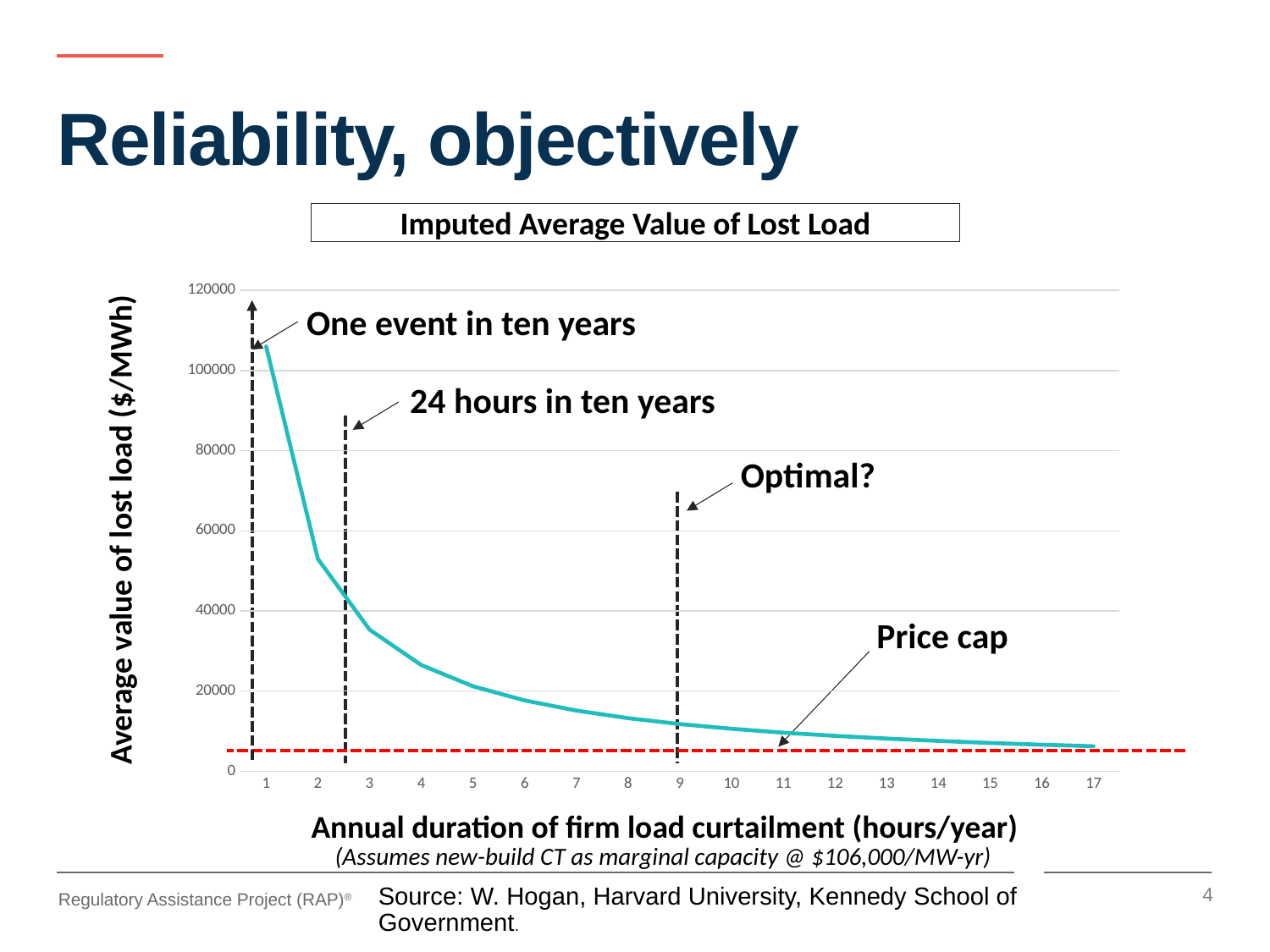
How many points are plotted along the x axis of the chart? 17 What label is given to the red dashed horizontal line near the bottom of the chart? Price cap At which x-axis value (hours/year) is the average value of lost load lowest? 17 Is the value at 1 hour/year greater or less than 100000? greater Is the value at 3 hours/year greater or less than 40000? less At which x-axis value (hours/year) is the average value of lost load highest? 1 Do the values rise or fall as the annual duration of firm load curtailment increases along the x axis? fall What kind of chart is shown on the slide? line chart Is the value at 9 hours/year greater or less than 20000? less What is the title of the chart? Imputed Average Value of Lost Load Which is larger, the value at 2 hours/year or the value at 4 hours/year? 2 hours/year